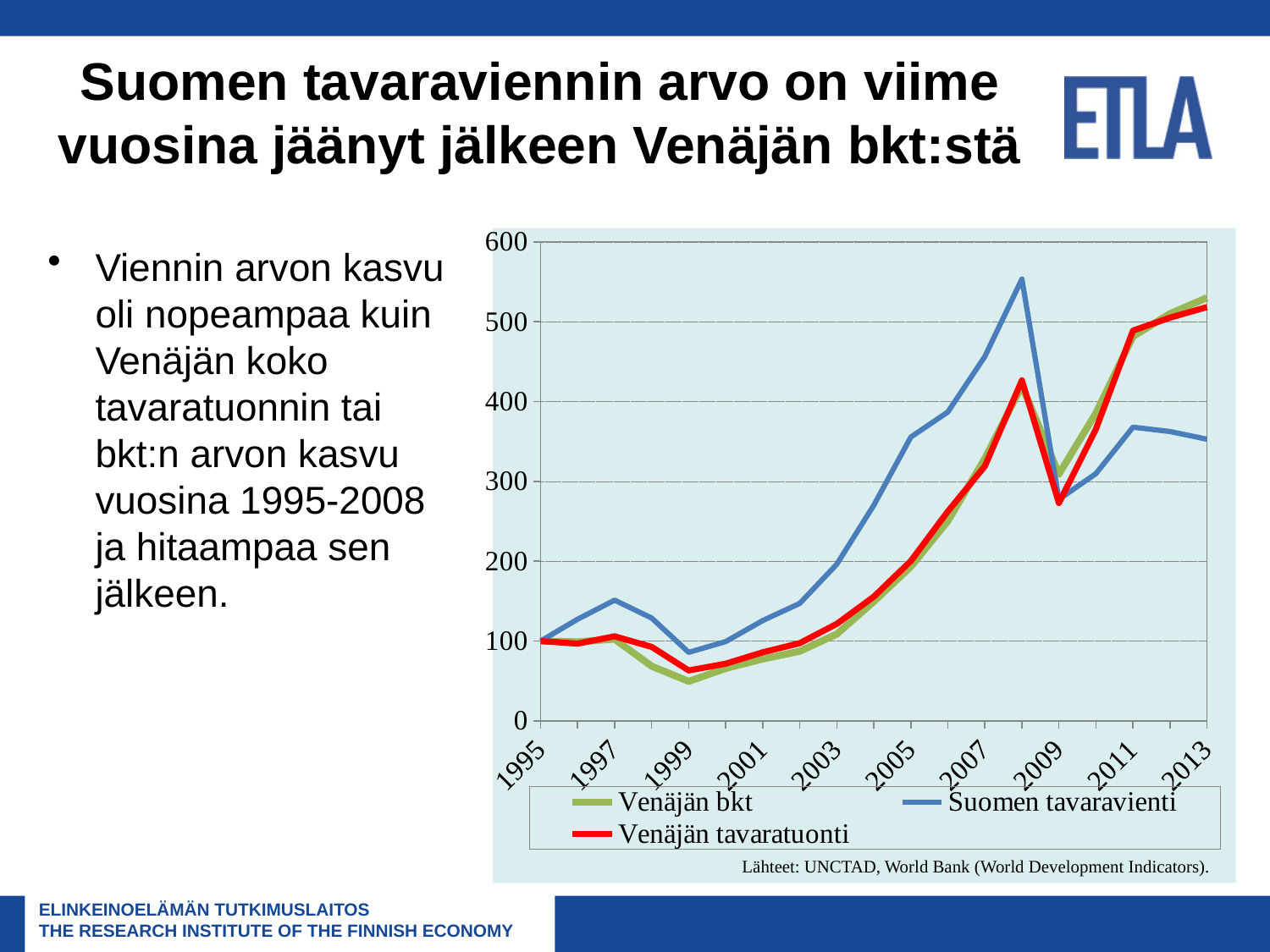
Is the value for Suomen tavaravienti in 2008 greater or less than 500? greater How many series does the chart's legend list? 3 Is the value for Venäjän bkt in 1999 greater or less than 100? less What colour is the Venäjän tavaratuonti line in the chart? Red Which series reaches the highest value in 2008? Suomen tavaravienti Is the value for Venäjän bkt in 2013 greater or less than 500? greater What kind of chart is shown on the slide? Line chart In 2005, which is larger: Suomen tavaravienti or Venäjän tavaratuonti? Suomen tavaravienti Which series has the lowest value in 2013? Suomen tavaravienti In 2013, which is larger: Venäjän bkt or Suomen tavaravienti? Venäjän bkt Does the Suomen tavaravienti series rise or fall from 2008 to 2013? Fall